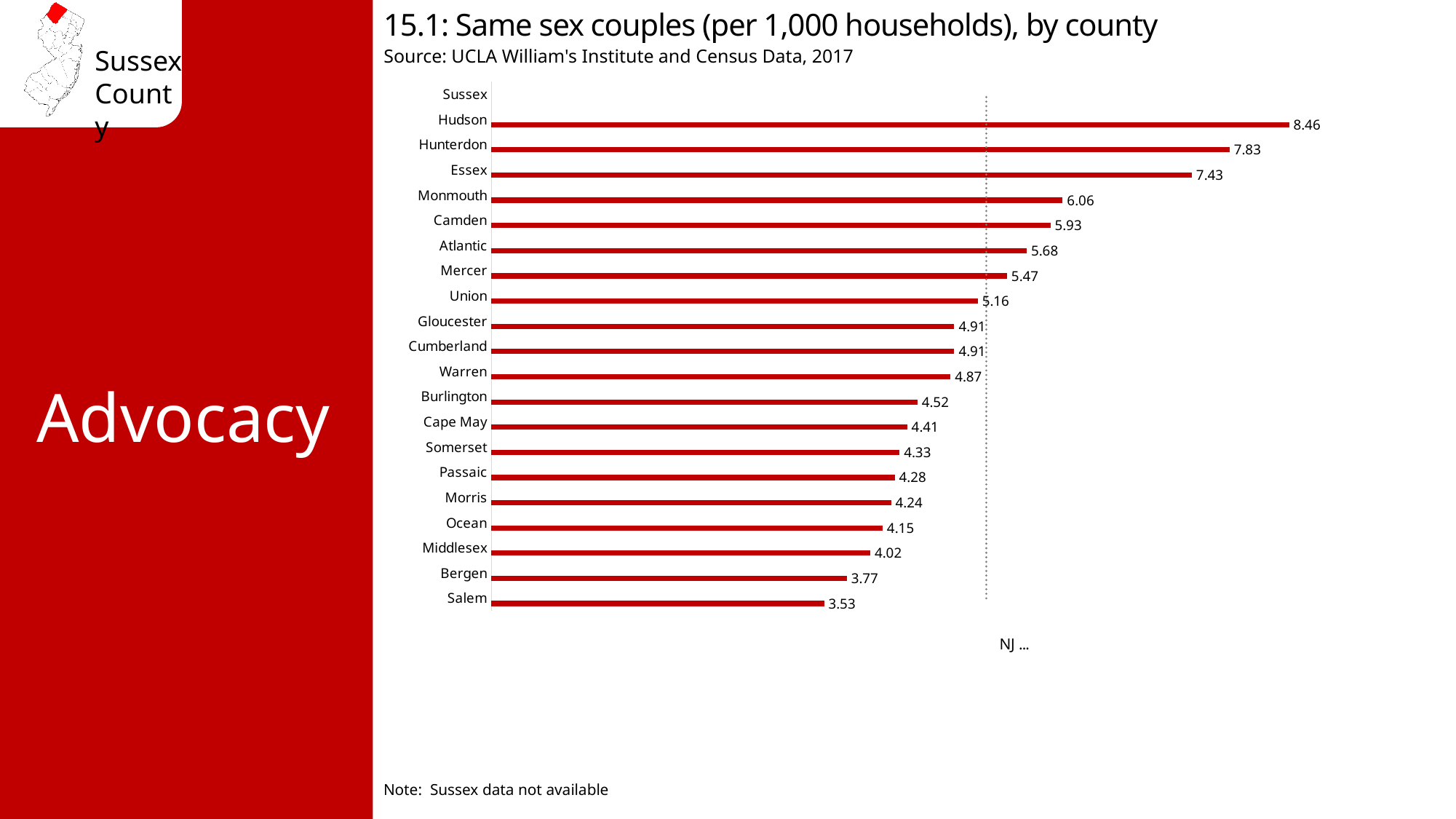
What is the value for Cape May? 4.41 Which county has the lowest value shown? Salem What kind of chart is shown on the slide? bar chart What is the value for Mercer? 5.47 Which is larger, the value for Monmouth or the value for Camden? Monmouth According to the note, which county's data is not available? Sussex What is the difference between the values for Hudson and Hunterdon? 0.63 What is the value for Hudson? 8.46 Which is larger, the value for Passaic or the value for Ocean? Passaic Which county has the highest value shown? Hudson What is the value for Salem? 3.53 What is the difference between the values for Bergen and Salem? 0.24